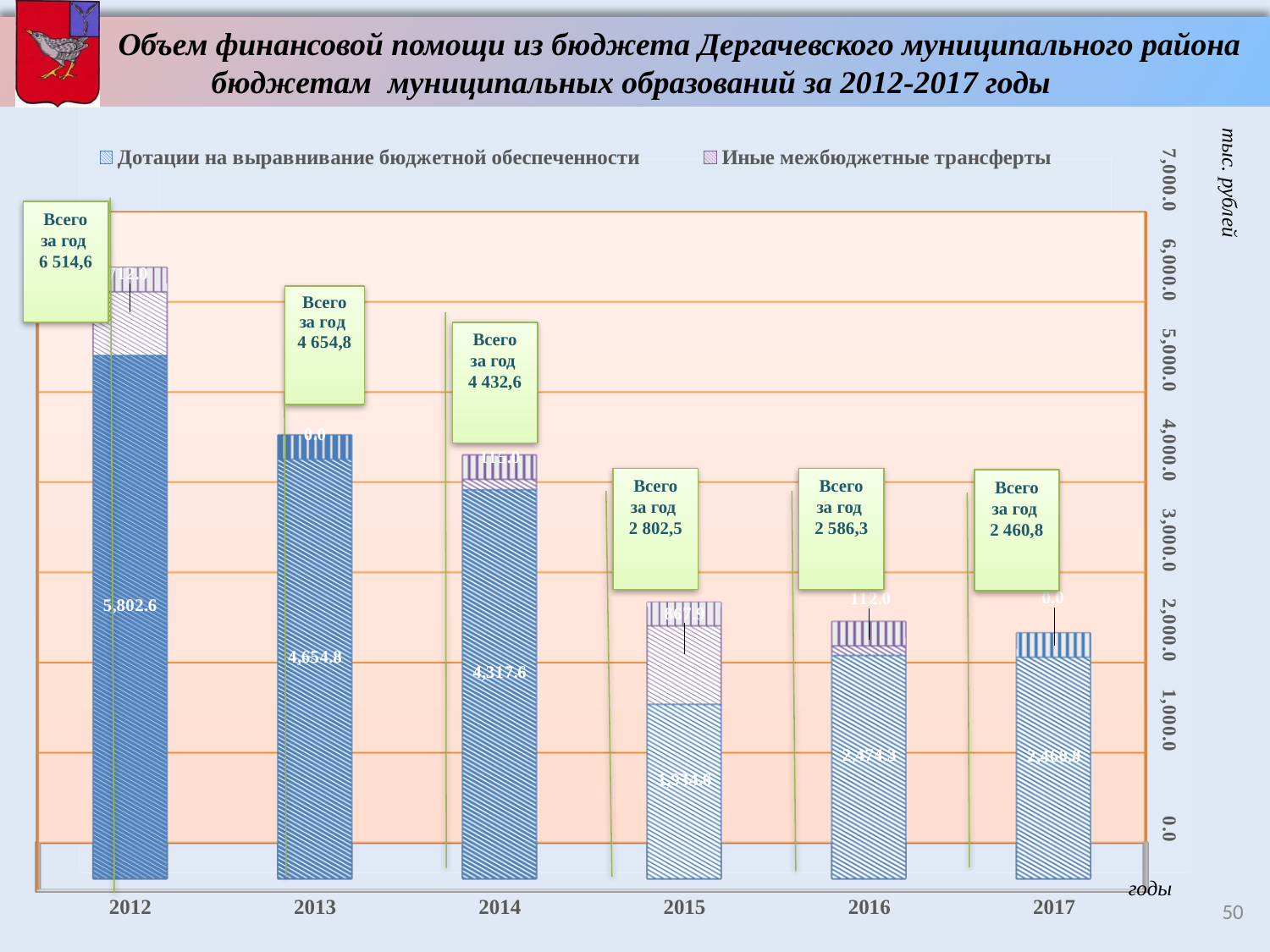
What is the total for the year 2017 according to the callout? 2 460,8 What is the difference between the totals for 2012 and 2013? 1 859,8 What is the value of 'Иные межбюджетные трансферты' for 2016? 112.0 Which year has the highest total financial assistance? 2012 What is the value of 'Дотации на выравнивание бюджетной обеспеченности' for 2012? 5,802.6 How many years are shown on the x axis? 6 How many series does the legend list? 2 Which year has the lowest total financial assistance? 2017 What is the total for the year 2012 according to the callout? 6 514,6 Do the yearly totals rise or fall from 2012 to 2017? fall Which is larger: 'Дотации на выравнивание бюджетной обеспеченности' in 2013 or in 2014? 2013 What kind of chart is shown on the slide? bar chart